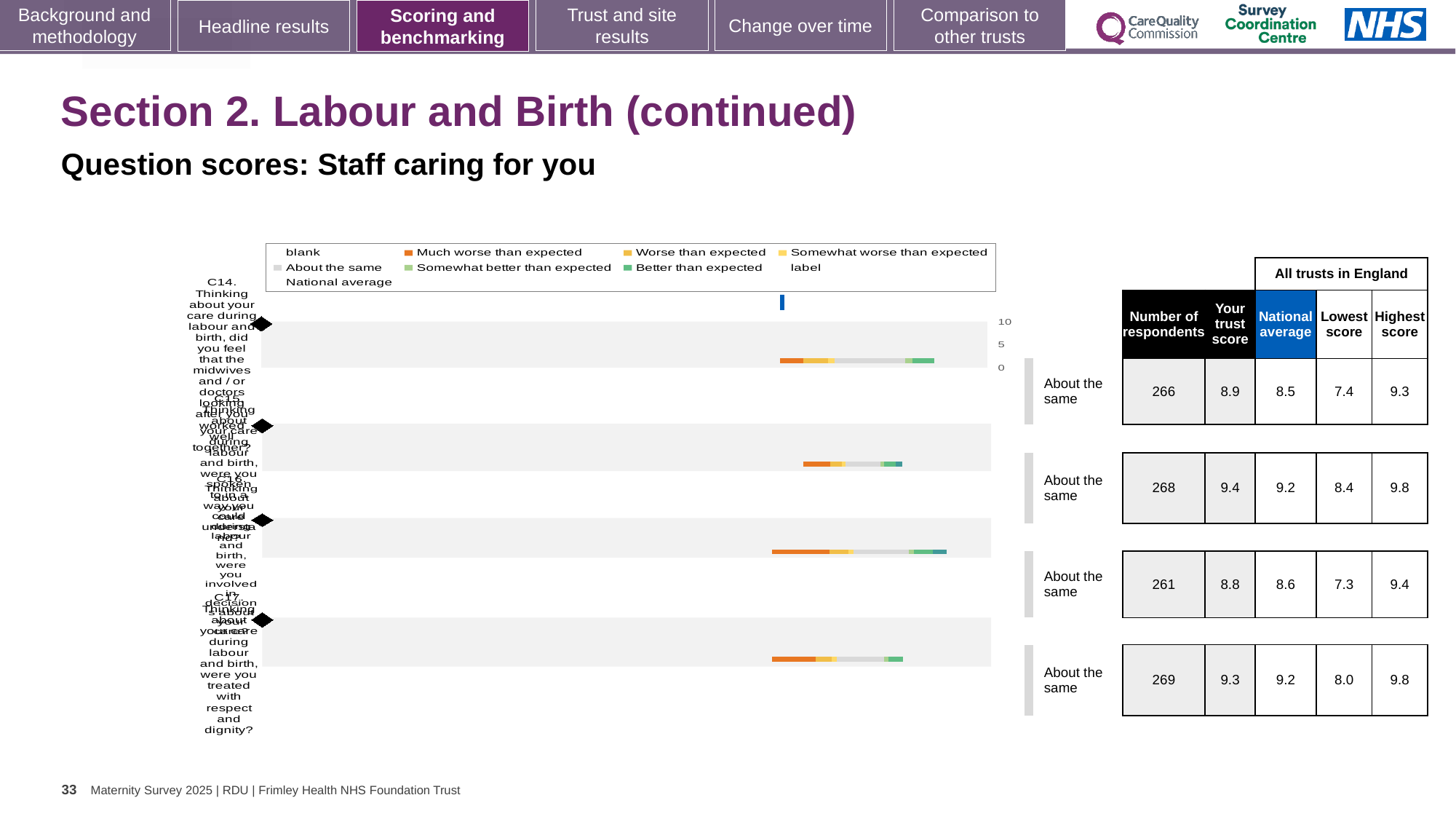
In the chart legend, which category is shown in orange? Much worse than expected Which has the larger trust score: the second question row (C15) or the third question row (C16)? C15 (9.4) What is the trust score for the first question row (C14)? 8.9 What is the national average for the first question row (C14)? 8.5 What is the number of respondents for the first question row (C14, midwives and/or doctors working well together)? 266 In the chart legend, which category is shown in dark green? Better than expected What is the lowest score among all trusts in England for the third question row (C16)? 7.3 What is the difference between the trust score and the national average for the first question row (C14)? 0.4 What kind of chart is shown on the slide? bar chart Which question row has the highest number of respondents? C17 (bottom row), 269 How many question rows (bars) does the chart show? 4 What is the highest score among all trusts in England for the second question row (C15)? 9.8